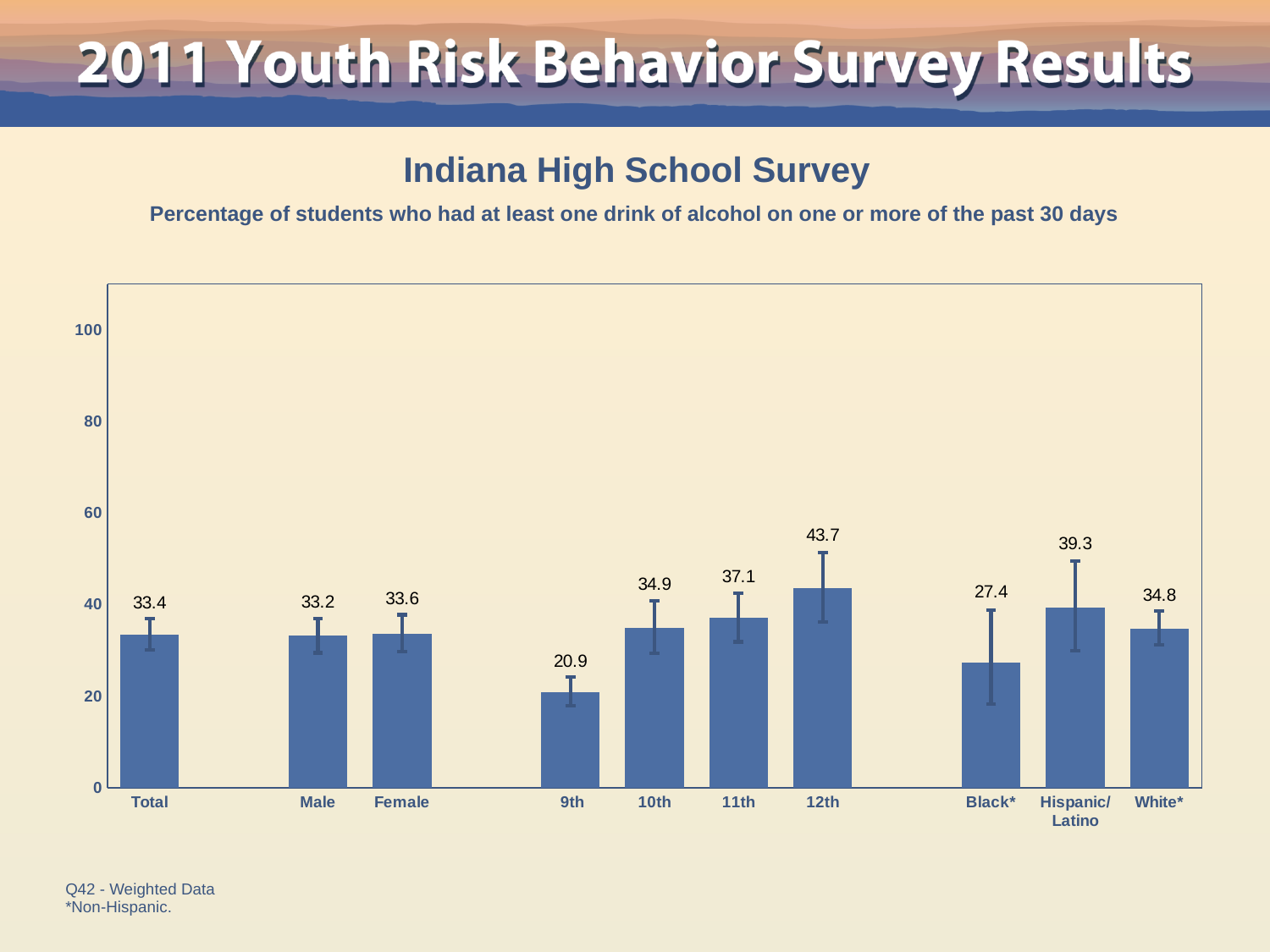
What is the value for Total? 33.4 Which category has the highest value? 12th What is the value for Hispanic/Latino students? 39.3 Is the value for Black* greater or less than 40? less Which is larger, the value for Male or the value for Female? Female How many categories are shown on the x axis? 10 What is the difference between the values for 12th and 9th grade? 22.8 Which category has the lowest value? 9th What kind of chart is shown? bar chart Do the values rise or fall from 9th grade to 12th grade? rise What is the value for 12th grade? 43.7 What is the difference between the values for White* and Black*? 7.4